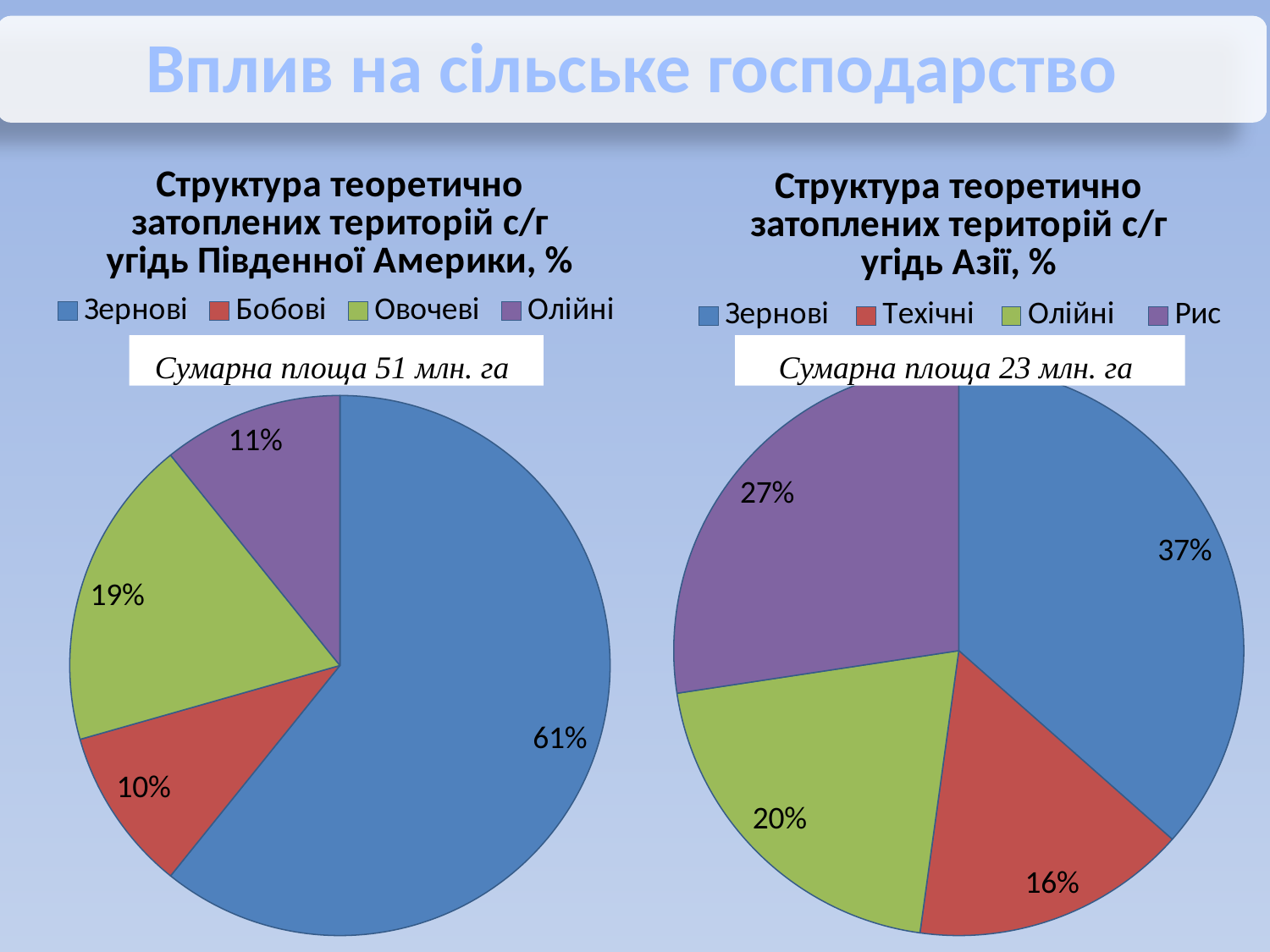
In the left pie chart (Південної Америки), which category has the smallest share? Бобові In the left pie chart (Південної Америки), what is the difference between the shares of Зернові and Овочеві? 42% In the left pie chart (Південної Америки), what share is labelled for Зернові? 61% In the right pie chart (Азії), which is larger: the share of Олійні or the share of Рис? Рис In the right pie chart (Азії), what share is labelled for Техічні? 16% What type of chart is used on the left side of the slide? Pie chart In the right pie chart (Азії), which category has the smallest share? Техічні In the right pie chart (Азії), what share is labelled for Рис? 27% How many categories does the legend of the right pie chart (Азії) list? 4 In the left pie chart (Південної Америки), what share is labelled for Овочеві? 19% What total area is stated in the text box above the right pie chart (Азії)? Сумарна площа 23 млн. га In the right pie chart (Азії), which category has the largest share? Зернові